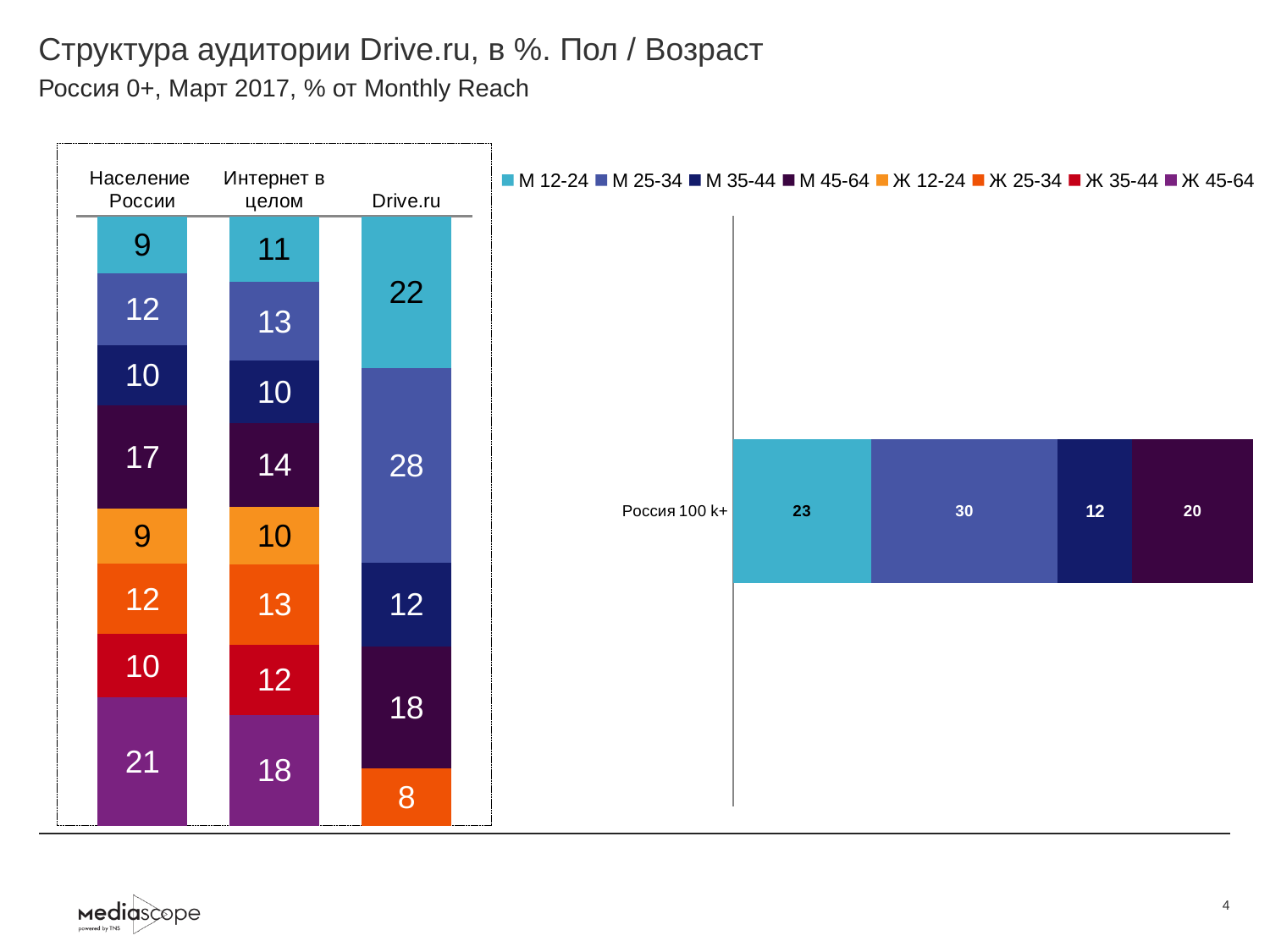
How many series does the legend list? 8 In the left stacked bar chart, what is the difference between the М 12-24 values for Drive.ru and Население России? 13 What kind of chart is shown on the right side of the slide? Stacked bar chart In the left stacked bar chart, which is larger: the Ж 45-64 value for Население России or for Интернет в целом? Население России In the right chart, what is the value of the М 25-34 segment for Россия 100 k+? 30 In the left stacked bar chart, what is the value of the М 45-64 segment for Интернет в целом? 14 In the left stacked bar chart, what is the value of the М 25-34 segment for Drive.ru? 28 In the right chart, which segment of the Россия 100 k+ bar is the smallest? М 35-44 In the right chart, what is the total of the Россия 100 k+ stacked bar? 85 In the left stacked bar chart, which segment of the Drive.ru bar is the largest? М 25-34 How many bars are in the left stacked bar chart? 3 In the left stacked bar chart, what is the value of the Ж 45-64 segment for Население России? 21